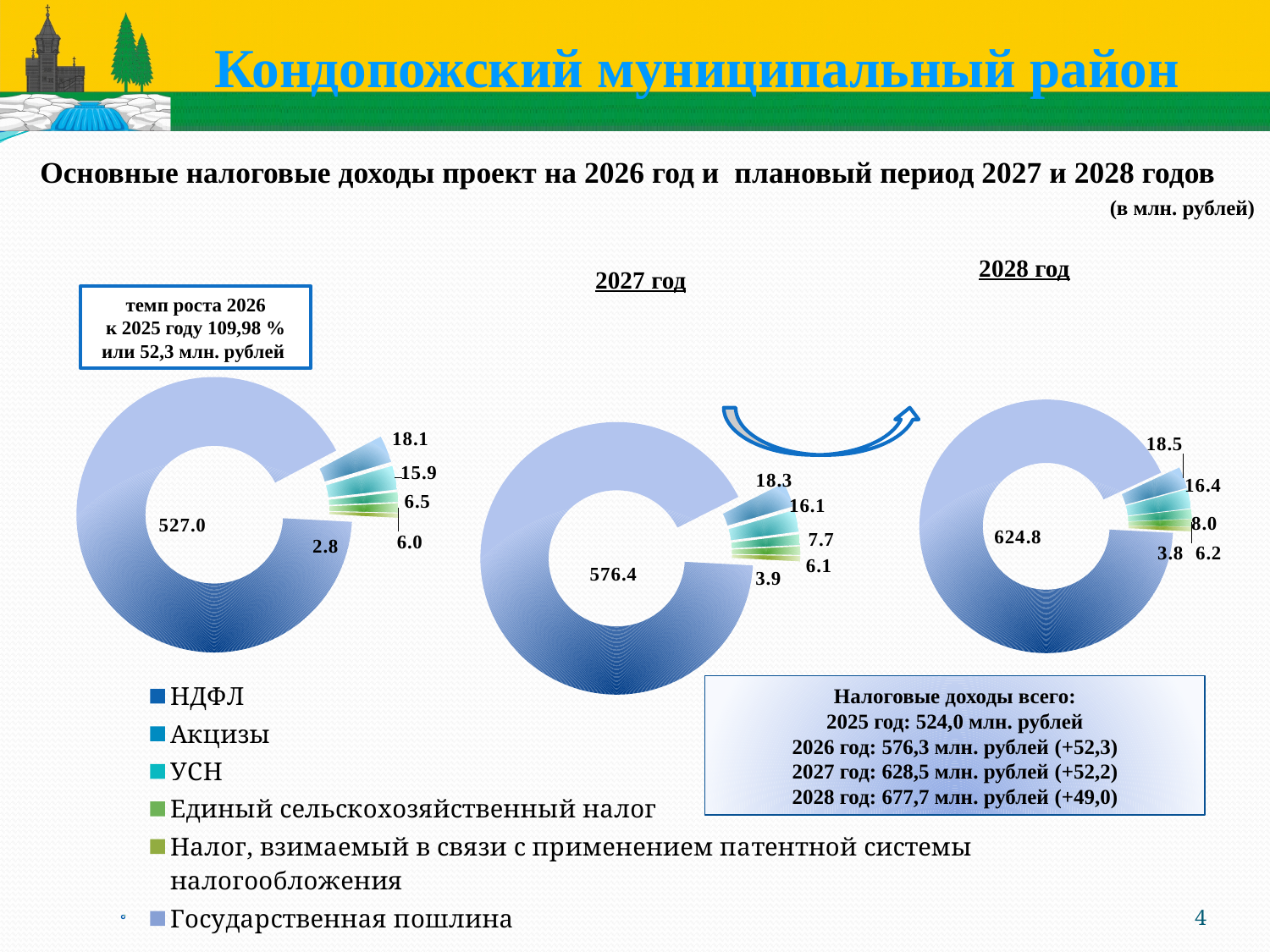
In the 2027 год chart, what is the smallest labelled value? 3.9 In the 2028 год chart, what is the value of the largest slice (НДФЛ)? 624.8 How many entries does the legend list? 6 Which is larger: the НДФЛ value in the 2027 год chart or in the 2028 год chart? 2028 год In the left chart, what is the smallest labelled value? 2.8 What is the difference between the НДФЛ value in the 2028 год chart (624.8) and in the 2027 год chart (576.4)? 48.4 In the left chart, what is the value of the largest slice (НДФЛ)? 527.0 In the 2028 год chart, what is the smallest labelled value? 3.8 How many slices does each doughnut chart on the slide have? 6 In the left chart, what is the difference between the slices labelled 18.1 and 15.9? 2.2 What type of chart is used on this slide? Doughnut (pie) chart In the 2027 год chart, what is the value of the largest slice (НДФЛ)? 576.4